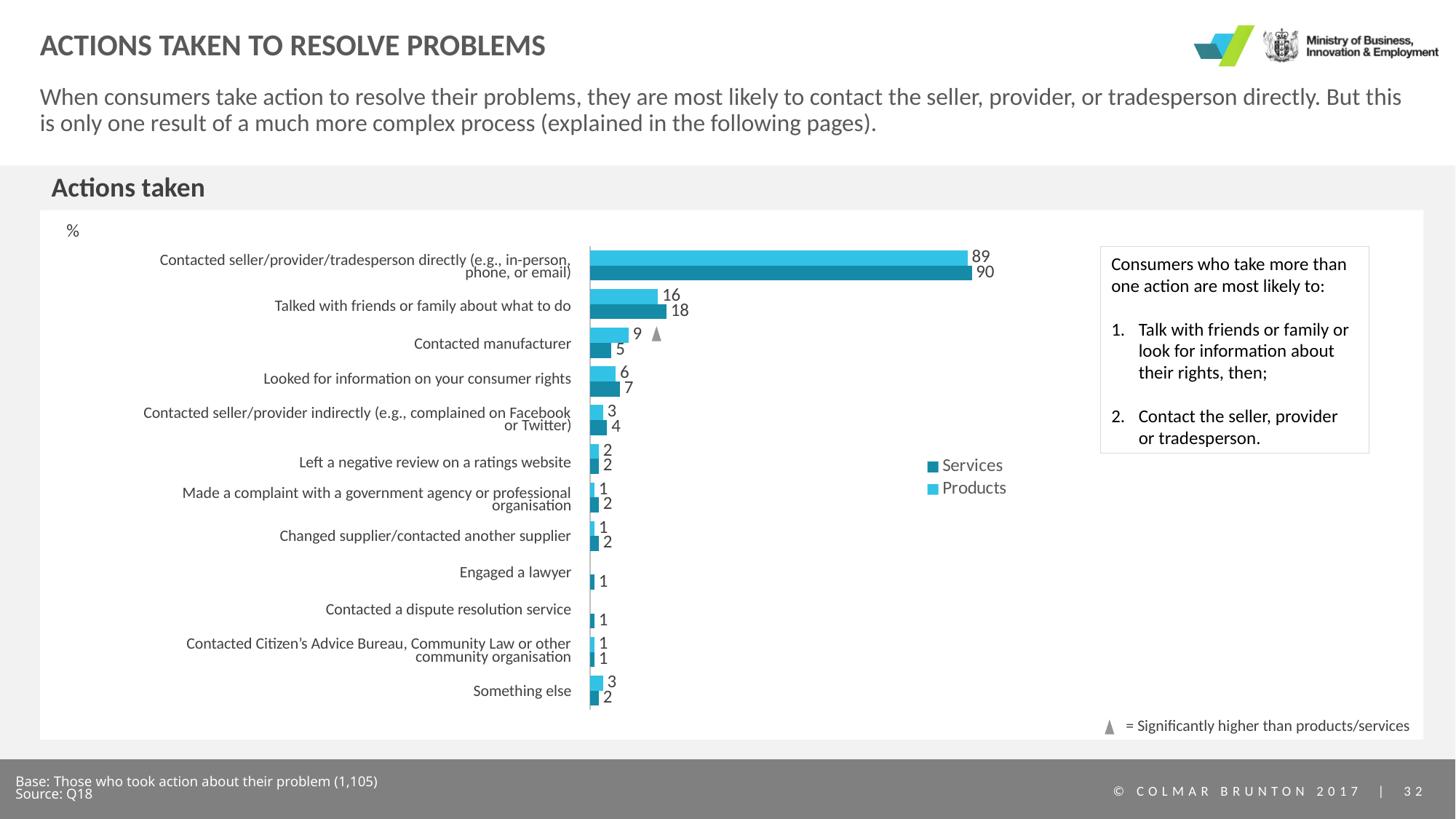
What is the difference between the Services and Products values for 'Talked with friends or family about what to do'? 2 What is the difference between the Products and Services values for 'Contacted manufacturer'? 4 How many series does the legend list? 2 What type of chart is used to show the actions taken? Bar chart For 'Contacted manufacturer', which series has the larger value, Services or Products? Products How many actions (categories) are listed in the chart? 12 Which action has the highest value for the Services series? Contacted seller/provider/tradesperson directly (e.g., in-person, phone, or email) What is the Products value for 'Contacted manufacturer'? 9 What is the Services value for 'Looked for information on your consumer rights'? 7 What percentage of Services respondents contacted the seller/provider/tradesperson directly? 90 What does the grey triangle symbol in the chart indicate? Significantly higher than products/services What percentage of Products respondents talked with friends or family about what to do? 16